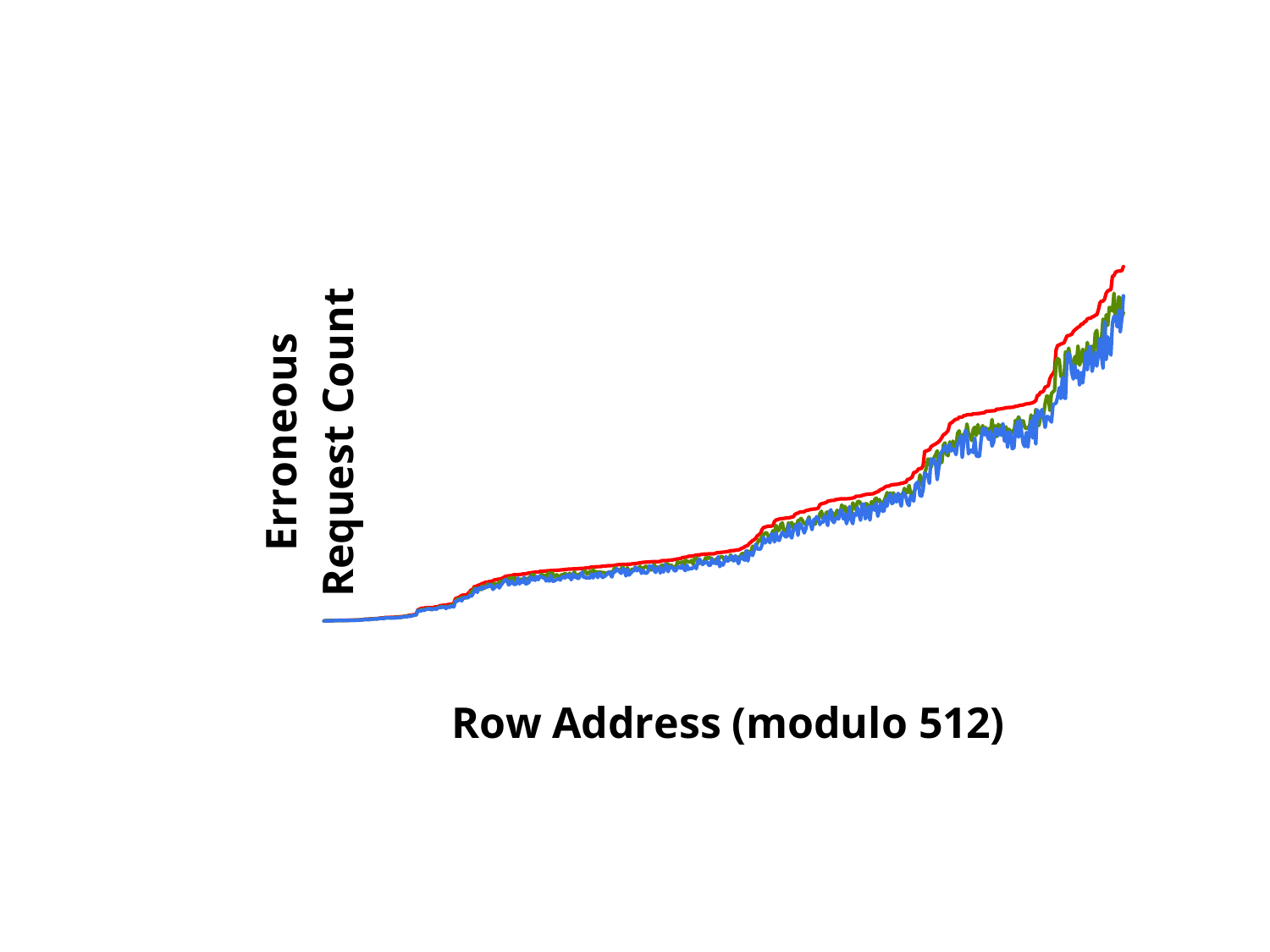
What is the label of the x axis? Row Address (modulo 512) What kind of chart is shown on the slide? line chart Do the plotted values rise or fall as the row address increases along the x axis? rise What is the label of the y axis? Erroneous Request Count Which coloured line reaches the highest value at the right end of the chart? red At the right end of the chart, is the red line or the blue line higher? red How many lines are plotted on the chart? 3